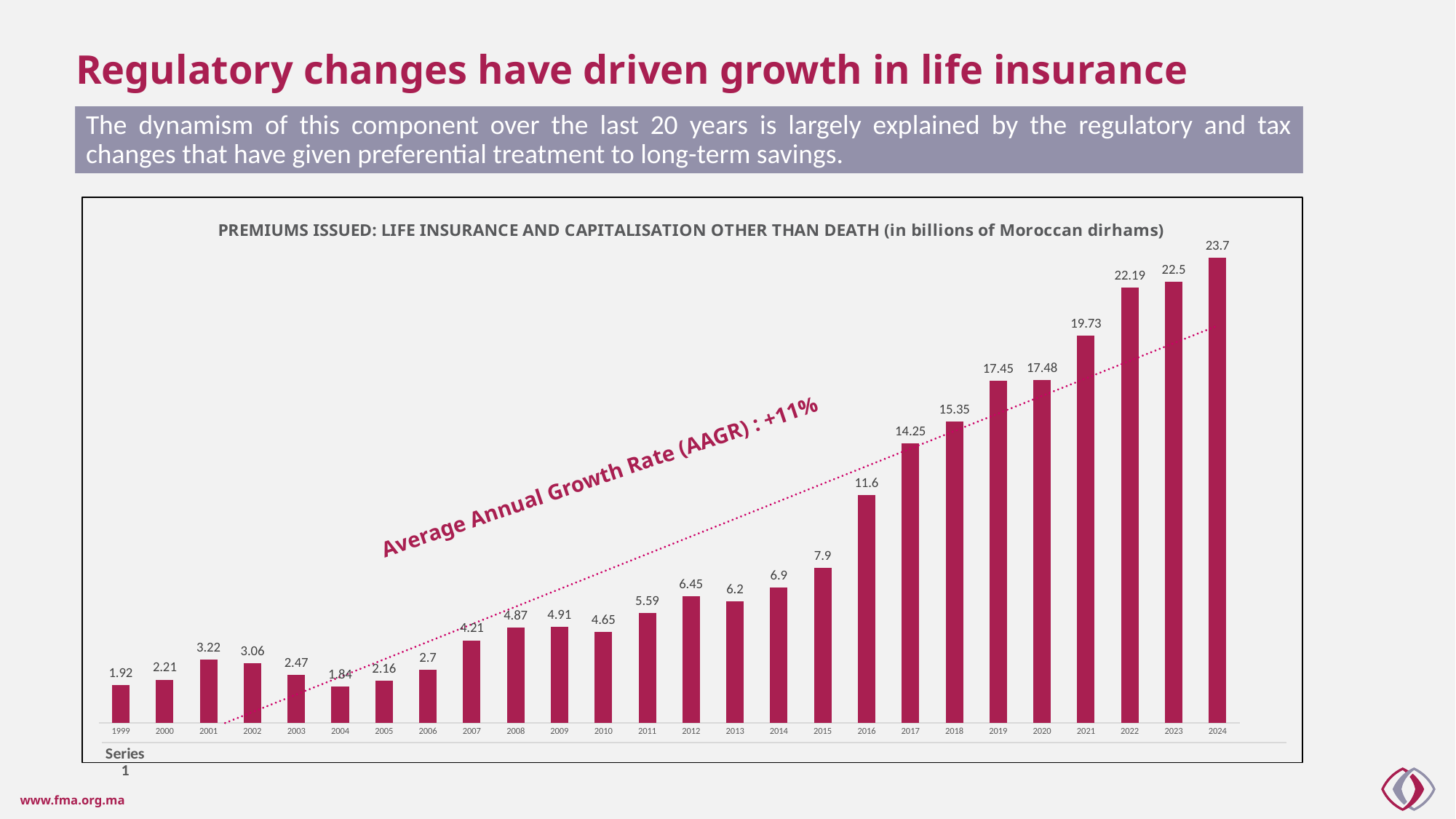
What is the value for 1999? 1.92 What is the difference between the values for 2017 and 2016? 2.65 How many years are shown on the x axis? 26 What is the value for 2024? 23.7 Which is larger, the value for 2001 or the value for 2002? 2001 What is the value for 2016? 11.6 What is the difference between the values for 2024 and 2023? 1.2 What kind of chart is shown on the slide? Bar chart Which year has the lowest value? 2004 What Average Annual Growth Rate (AAGR) is stated on the chart? +11% Which year has the highest value? 2024 Do the values generally rise or fall from 1999 to 2024? Rise